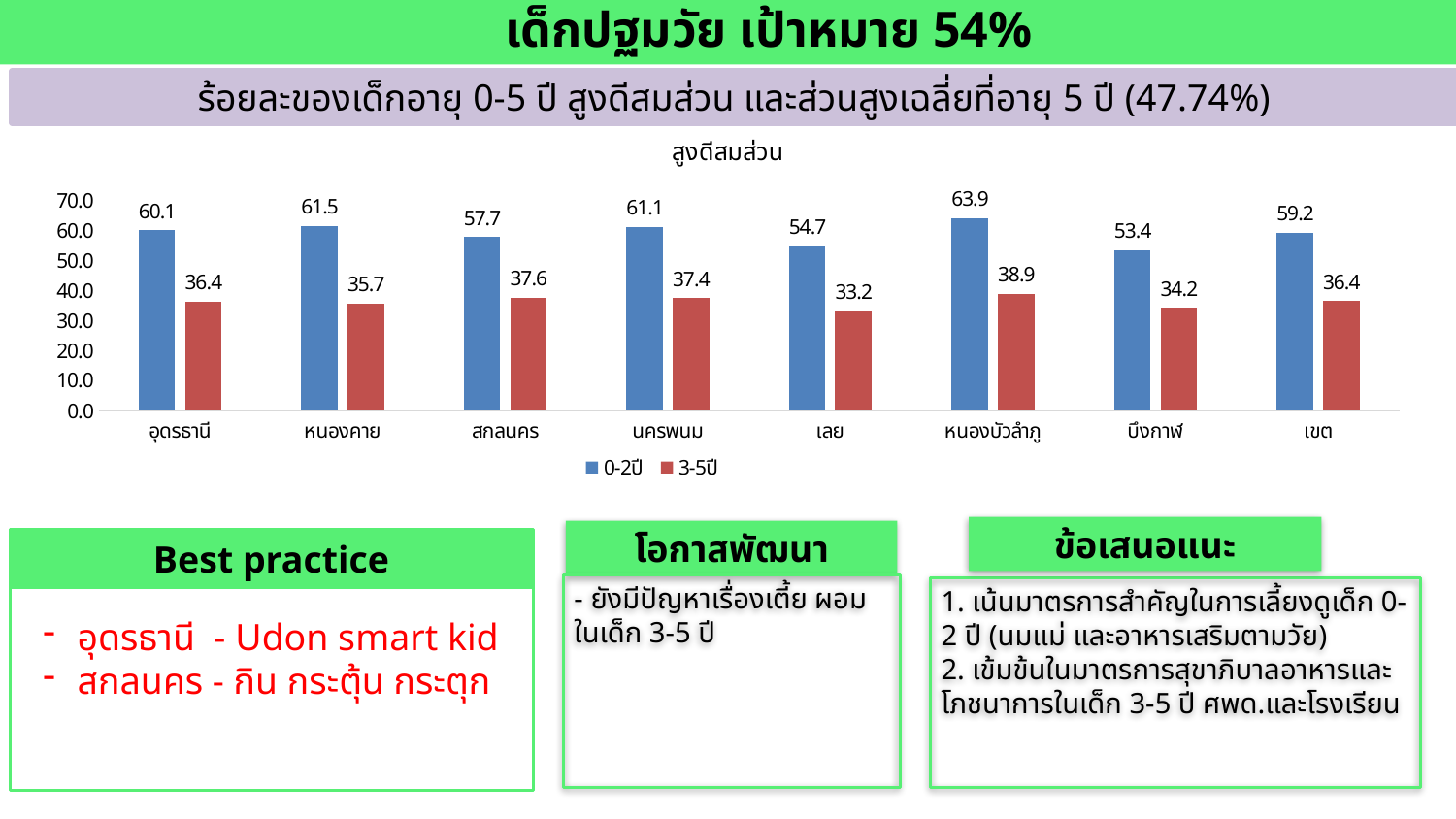
What is the difference between the 0-2ปี and 3-5ปี values for หนองบัวลำภู? 25.0 What is the title of the chart? สูงดีสมส่วน Which category has the highest value in the 0-2ปี series? หนองบัวลำภู Which category has the lowest value in the 3-5ปี series? เลย How many categories are shown on the x axis? 8 Which is larger: the 3-5ปี value for สกลนคร or the 3-5ปี value for หนองคาย? สกลนคร What is the value for เลย in the 3-5ปี series? 33.2 How many series does the legend list? 2 What is the value for อุดรธานี in the 0-2ปี series? 60.1 Which category has the lowest value in the 0-2ปี series? บึงกาฬ What is the value for เขต in the 0-2ปี series? 59.2 What kind of chart is shown on the slide? bar chart